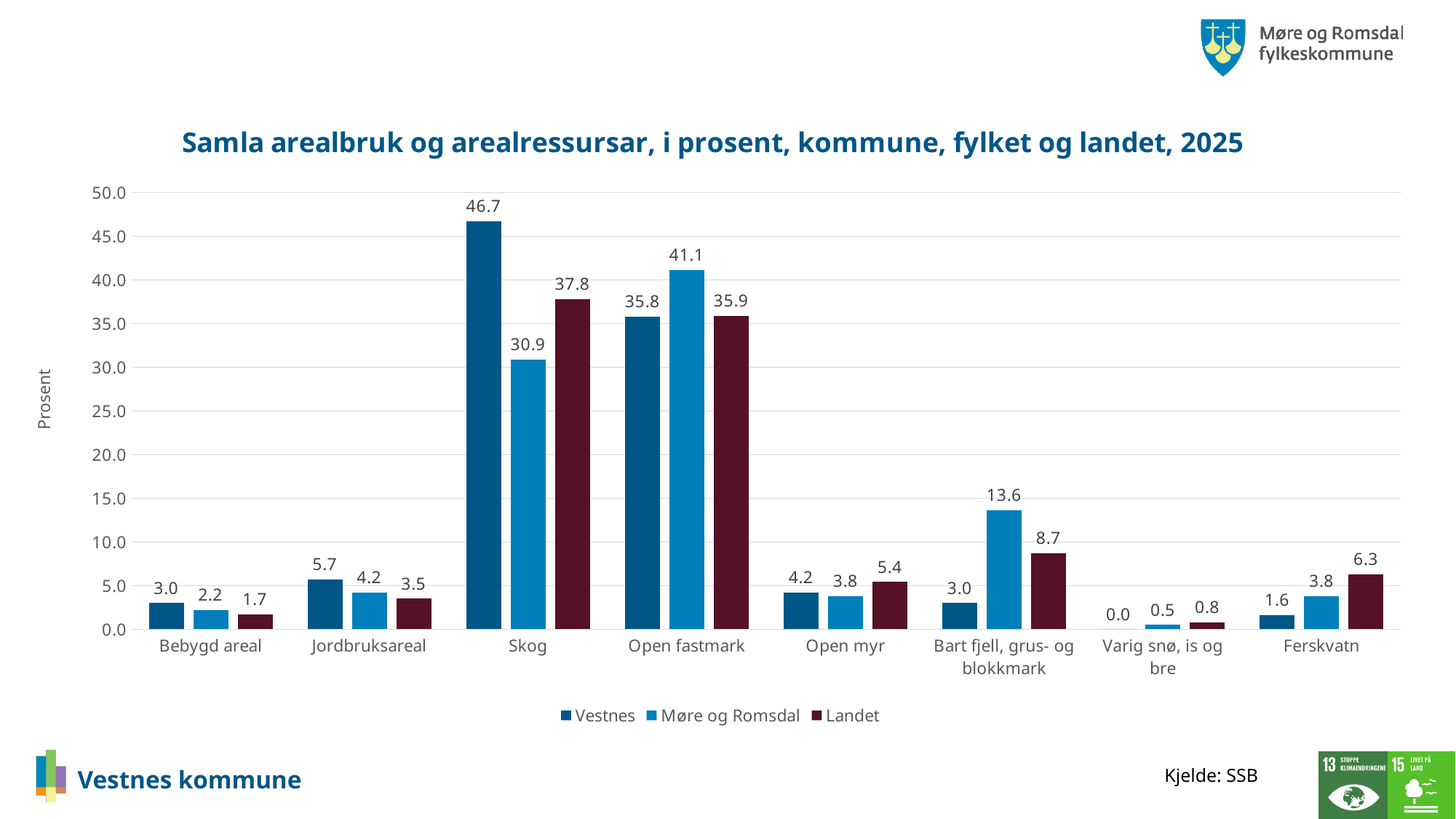
What is the title of the chart? Samla arealbruk og arealressursar, i prosent, kommune, fylket og landet, 2025 What kind of chart is shown on the slide? Bar chart How many series does the legend list? 3 What is the value for Landet in the Bart fjell, grus- og blokkmark category? 8.7 What is the value for Vestnes in the Skog category? 46.7 How many categories are shown on the x axis? 8 What is the difference between the Vestnes and Møre og Romsdal values for Skog? 15.8 Which category has the lowest value for Møre og Romsdal? Varig snø, is og bre Which is larger for Ferskvatn: the value for Vestnes or the value for Landet? Landet Which category has the highest value for Vestnes? Skog What is the value for Møre og Romsdal in the Open fastmark category? 41.1 Is the value for Landet in the Skog category greater or less than 35.0? greater